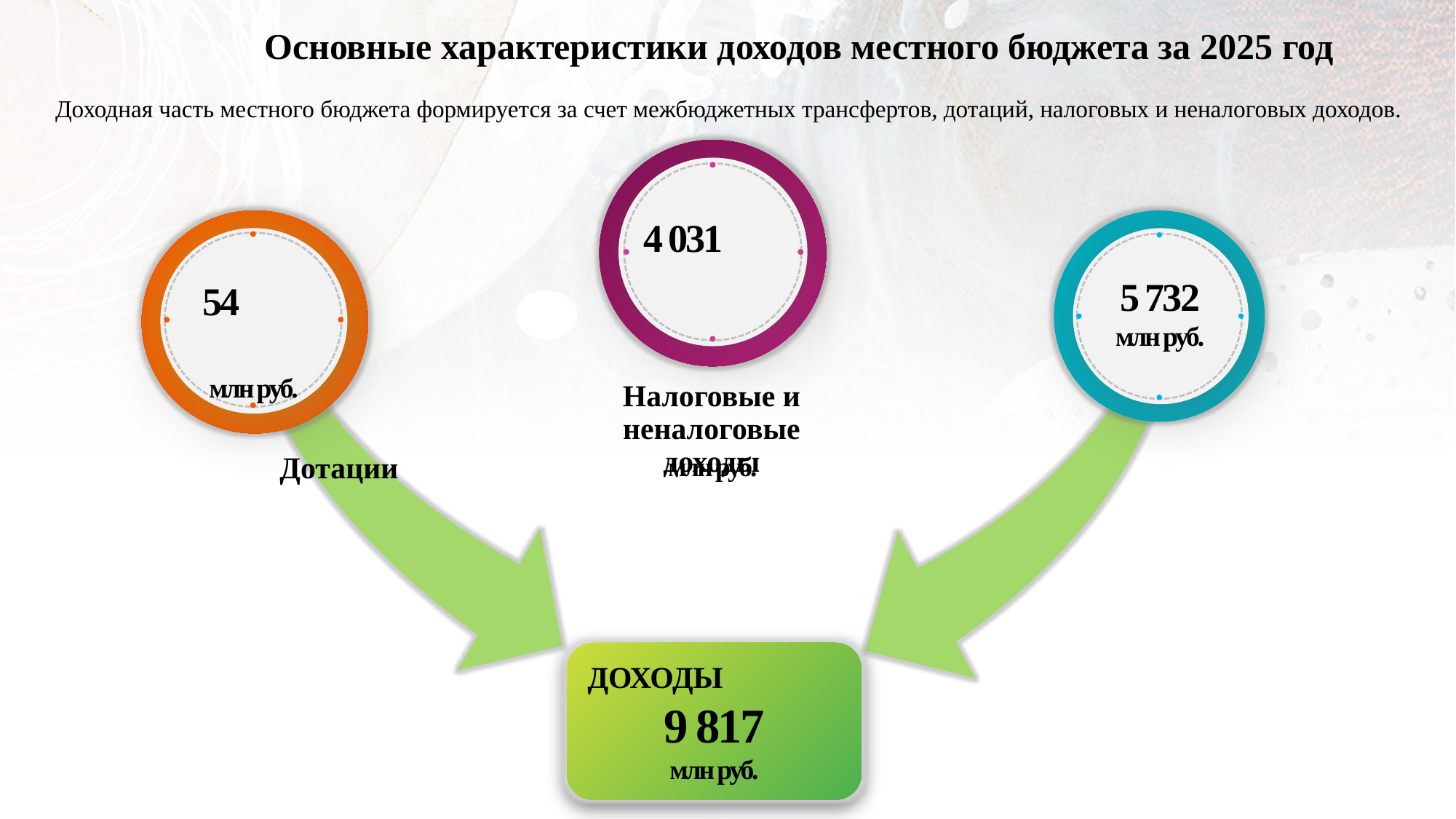
What is the title of the slide? Основные характеристики доходов местного бюджета за 2025 год How many circles with values are shown on the slide? 3 What is the difference between the value in the blue circle (5 732) and the value for Налоговые и неналоговые доходы (4 031)? 1 701 млн руб. What total is shown in the ДОХОДЫ box at the bottom? 9 817 млн руб. What value is shown for Налоговые и неналоговые доходы? 4 031 млн руб. Which of the three circles shows the smallest value? Дотации (54 млн руб.) What value is shown in the blue circle on the right? 5 732 млн руб. What value is shown for Дотации? 54 млн руб. Which of the three circles shows the largest value? The blue circle on the right (5 732 млн руб.) What is the difference between the value for Налоговые и неналоговые доходы and the value for Дотации? 3 977 млн руб. What colour is the circle for Дотации? Orange Which is larger, the value for Дотации or the value for Налоговые и неналоговые доходы? Налоговые и неналоговые доходы